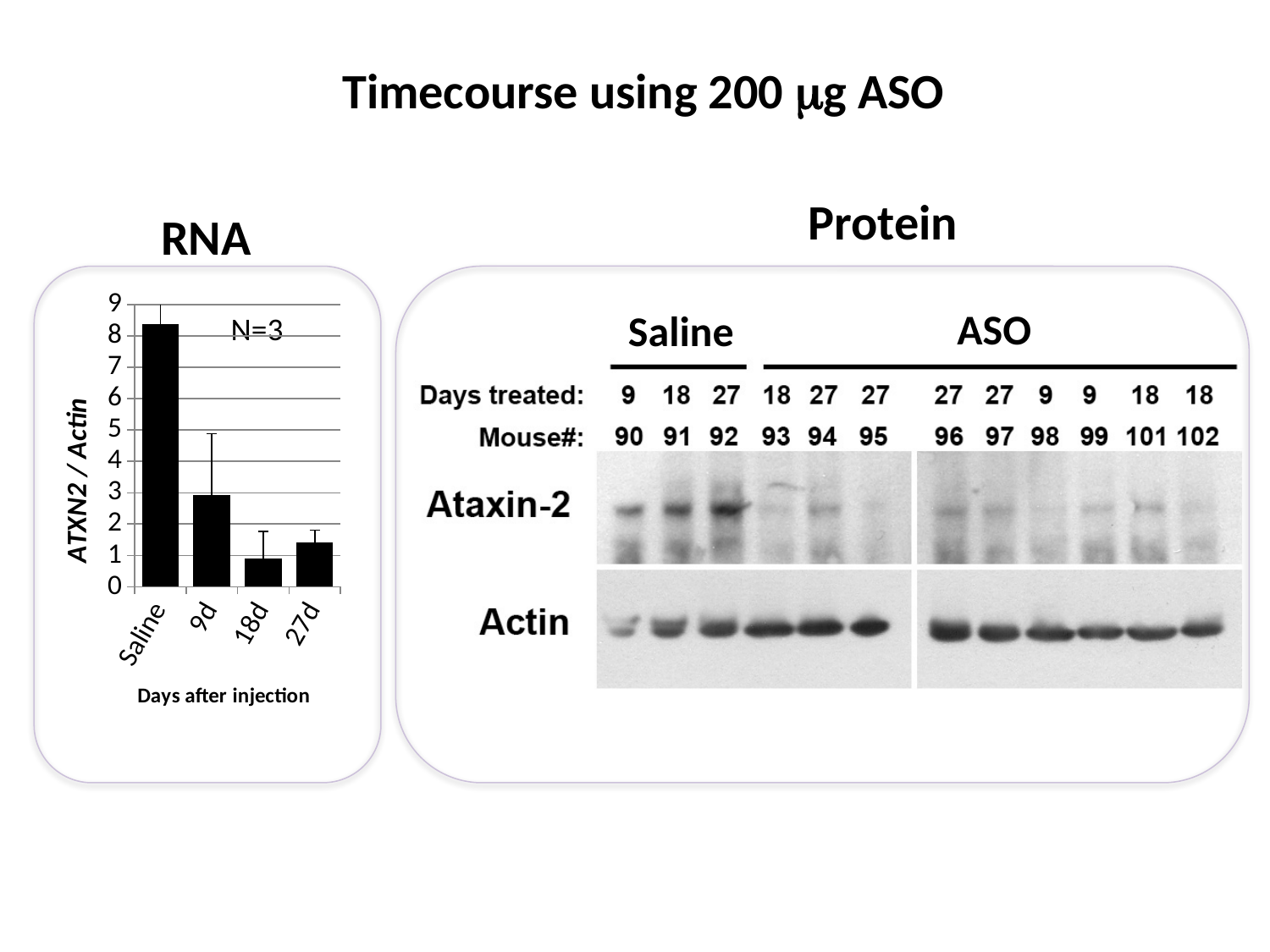
What is the y-axis label of the RNA bar chart? ATXN2 / Actin In the RNA bar chart, is the value for 18d greater or less than 2? less In the RNA bar chart, which category has the highest ATXN2 / Actin value? Saline In the RNA bar chart, is the value for 9d greater or less than 4? less In the RNA bar chart, how many categories are plotted on the x axis? 4 In the RNA bar chart, which has the larger value, 18d or 27d? 27d In the RNA bar chart, do the values rise or fall from Saline to 18d? fall In the RNA bar chart, is the value for Saline greater or less than 7? greater In the RNA bar chart, which has the larger value, 9d or 27d? 9d What kind of chart is shown in the RNA panel? bar chart In the RNA bar chart, which category has the lowest ATXN2 / Actin value? 18d